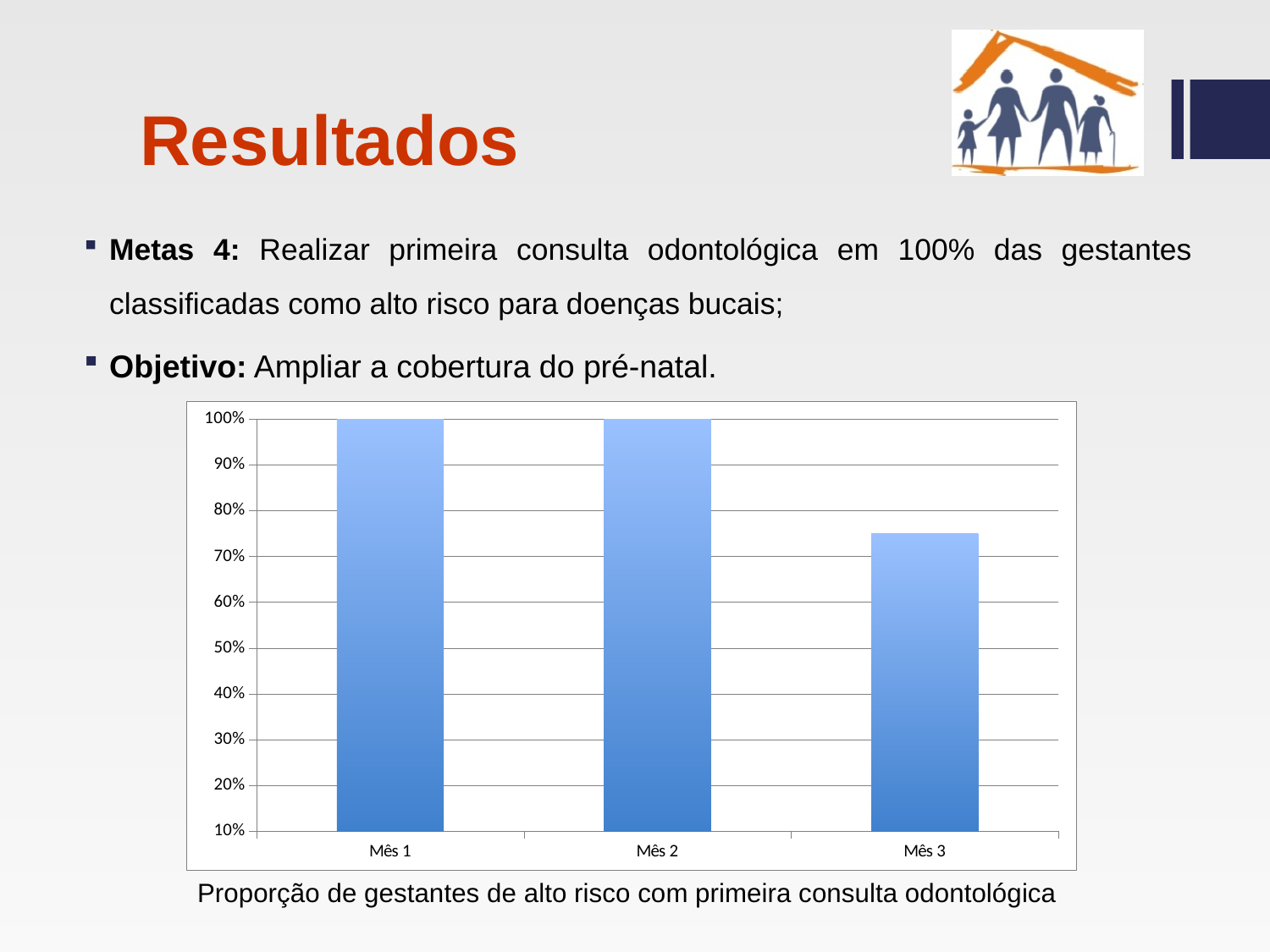
Is the value for Mês 3 greater or less than 80%? less What is the value for Mês 1 in the chart? 100% What caption is written directly below the chart? Proporção de gestantes de alto risco com primeira consulta odontológica Is the value for Mês 3 greater or less than 70%? greater Do the values rise or fall from Mês 2 to Mês 3? fall What is the highest tick value shown on the vertical axis of the chart? 100% How many categories (months) are shown on the x axis of the chart? 3 What type of chart is shown on the slide? bar chart Which month has the lowest value in the chart? Mês 3 Which is larger, the value for Mês 1 or the value for Mês 3? Mês 1 What is the value for Mês 2 in the chart? 100%